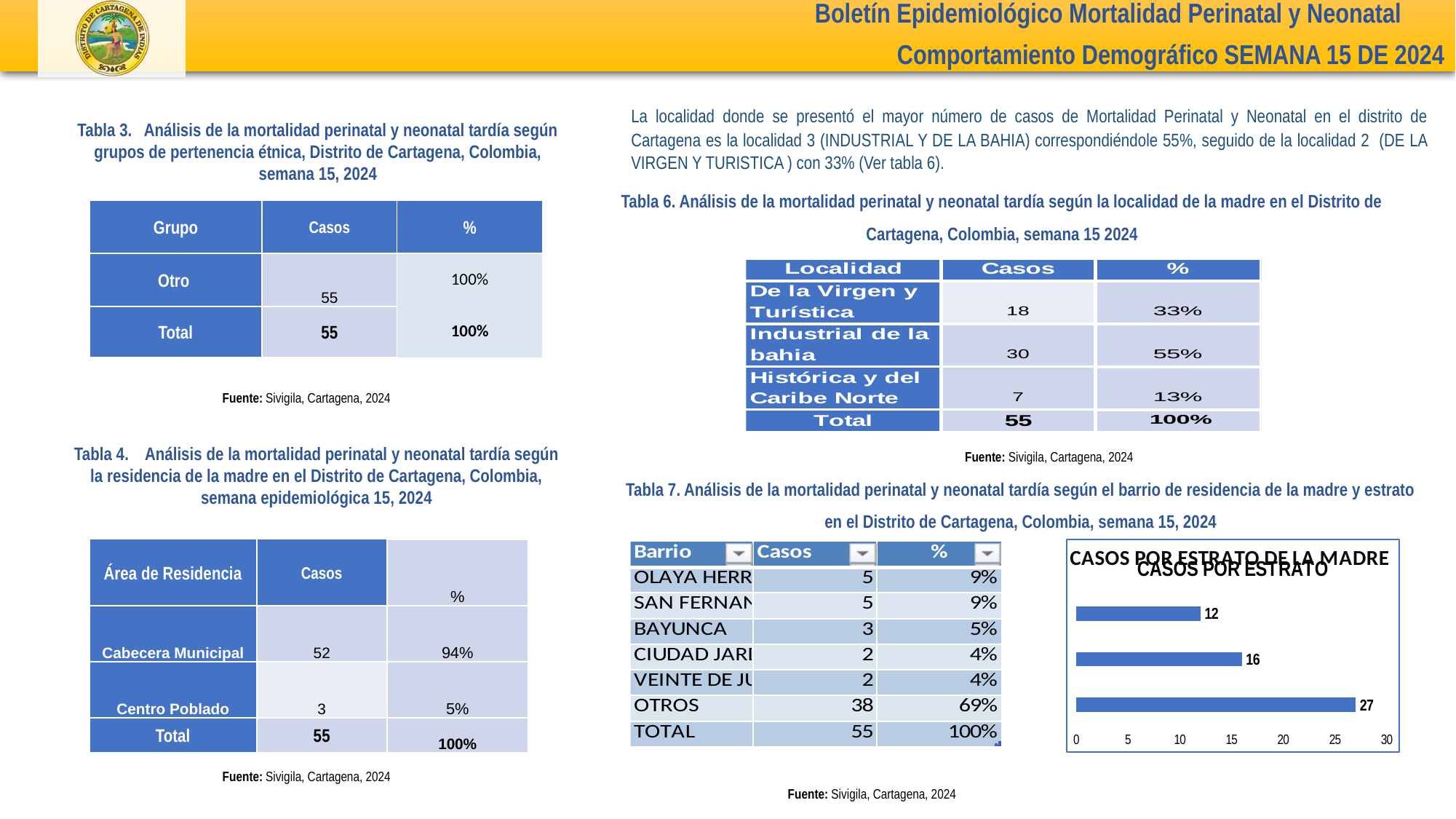
How many bars does the bar chart on the slide show? 3 In the bar chart, is the value of the bottom bar greater or less than 25? greater What is the largest tick value shown on the horizontal axis of the bar chart? 30 In the bar chart, what is the difference between the bottom bar's value and the top bar's value? 15 What is the value labelled on the top bar of the bar chart? 12 What kind of chart is shown on the right side of the slide under Tabla 7? bar chart What is the highest value shown in the bar chart? 27 What is the value labelled on the bottom bar of the bar chart? 27 What is the value labelled on the middle bar of the bar chart? 16 What is the sum of the three values shown in the bar chart? 55 What is the lowest value shown in the bar chart? 12 In the bar chart, which bar is longer, the middle bar or the bottom bar? the bottom bar